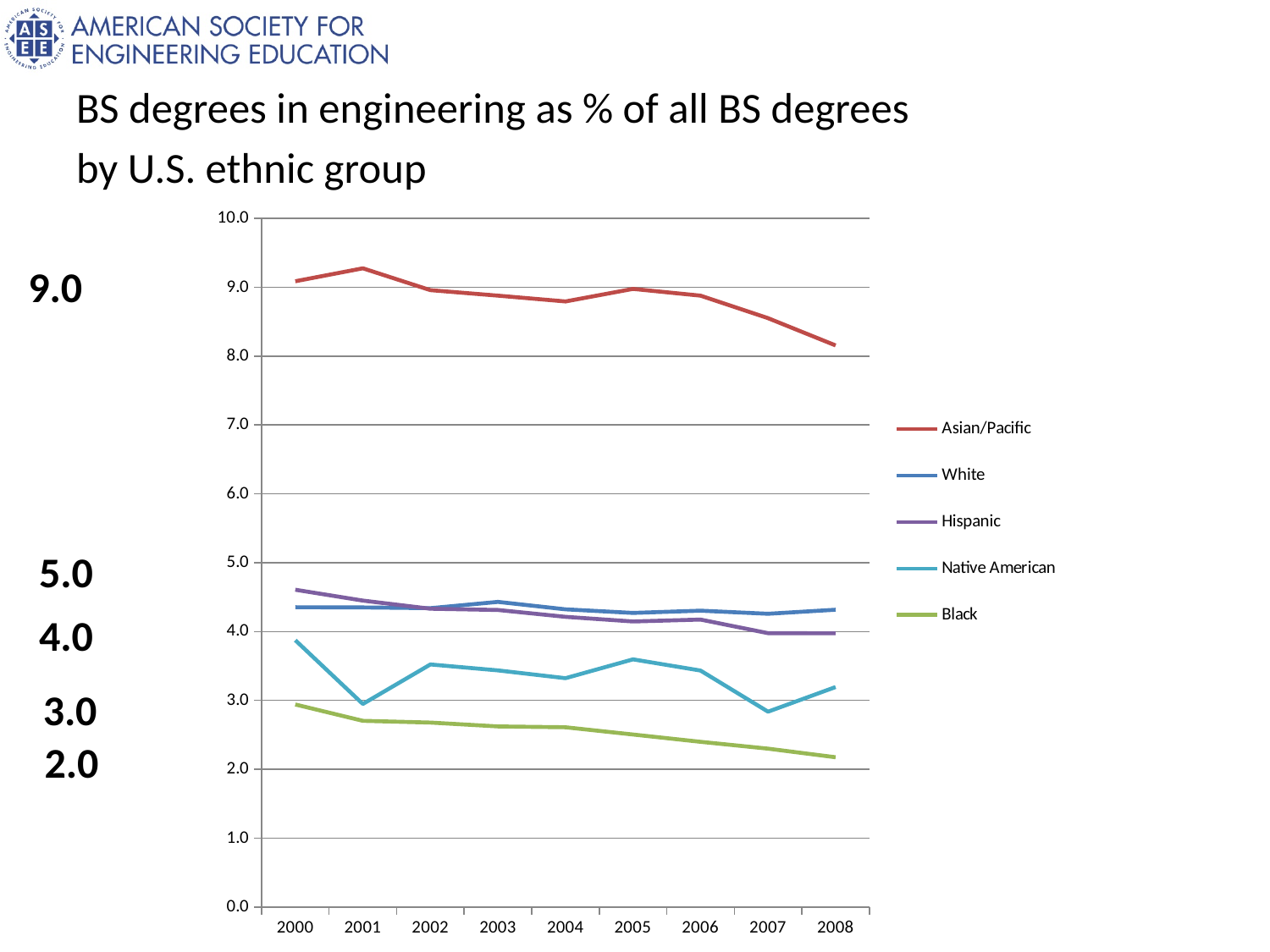
Is the value for Native American in 2007 greater or less than 3.0? less Which ethnic group has the highest values across all years? Asian/Pacific How many years are plotted along the x axis? 9 Which ethnic group has the lowest values across all years? Black How many series does the legend list? 5 In 2008, which is higher: White or Hispanic? White Is the value for Asian/Pacific in 2001 greater or less than 9.0? greater What is the title of the chart on the slide? BS degrees in engineering as % of all BS degrees by U.S. ethnic group Is the value for Hispanic in 2000 greater or less than 4.0? greater Does the Black series rise or fall from 2000 to 2008? fall What kind of chart is shown on the slide? line chart